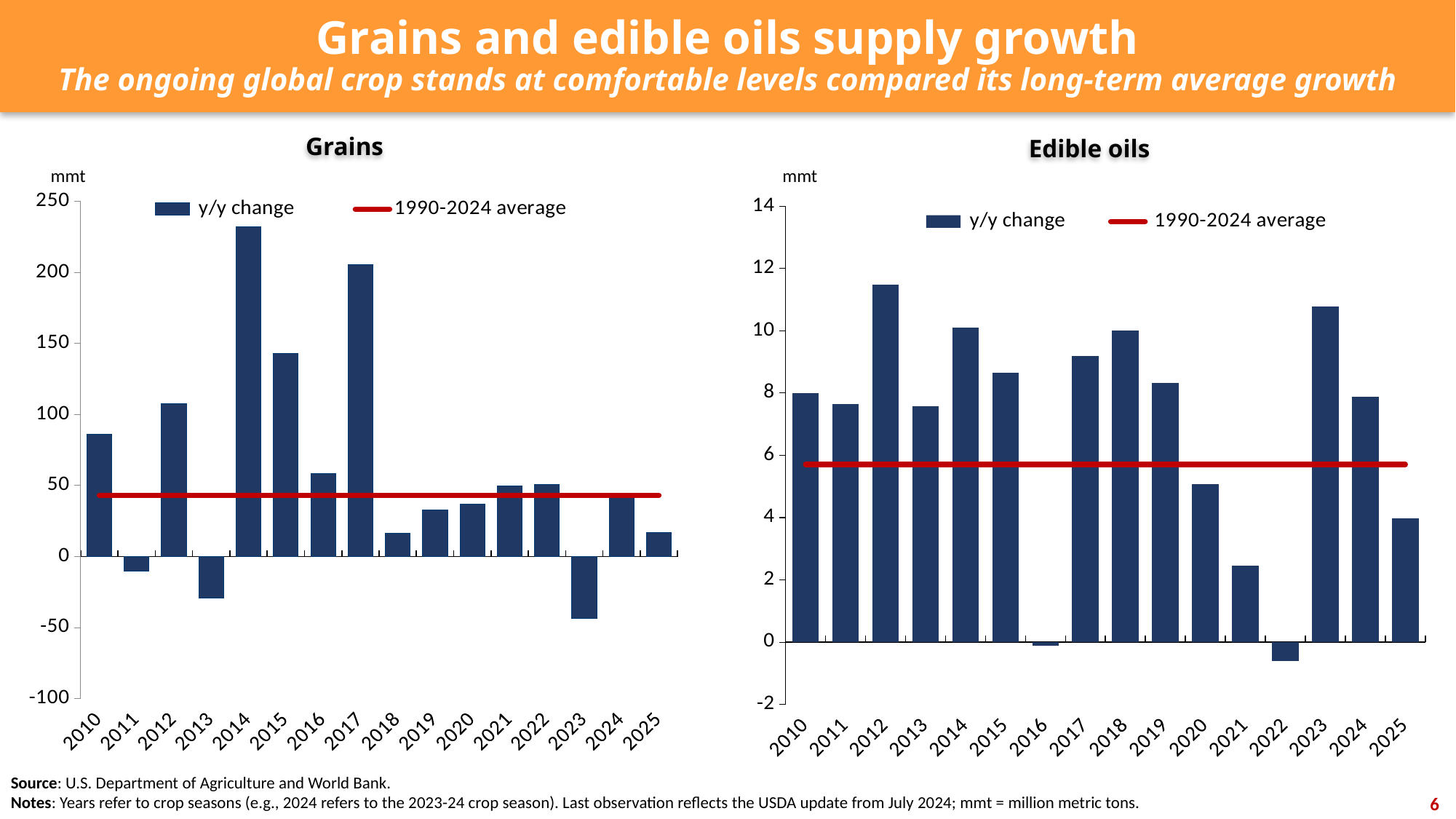
On the Grains chart, which year has the highest y/y change? 2014 On the Grains chart, is the y/y change for 2017 greater or less than 200? greater On the Grains chart, which is larger, the y/y change for 2014 or for 2017? 2014 On the Grains chart, is the y/y change for 2013 greater or less than 0? less On the Edible oils chart, which year has the highest y/y change? 2012 On the Grains chart, which year has the lowest y/y change? 2023 On the Edible oils chart, which is larger, the y/y change for 2012 or for 2013? 2012 What kind of chart is the Grains chart? combination bar and line chart On the Edible oils chart, is the y/y change for 2021 greater or less than 4? less How many series does the legend of the Edible oils chart list? 2 On the Grains chart, how many years are shown on the x axis? 16 On the Edible oils chart, which year has the lowest y/y change? 2022